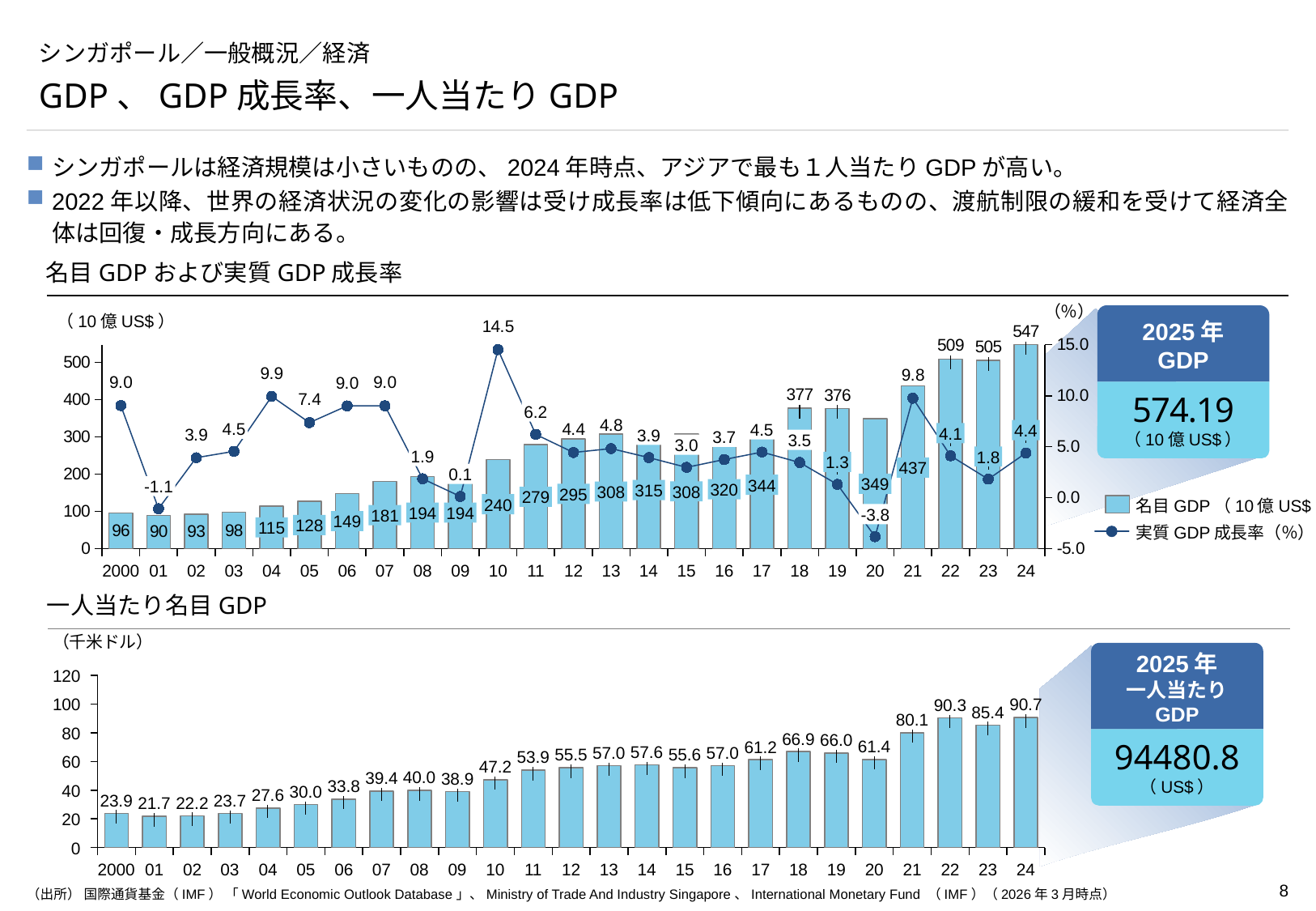
In the top chart (名目GDPおよび実質GDP成長率), what is the difference between the nominal GDP of 2022 and 2021? 72 In the bottom chart (一人当たり名目GDP), which year has the lowest value? 2001 What kind of chart is the bottom chart (一人当たり名目GDP)? Bar chart In the top chart (名目GDPおよび実質GDP成長率), which year has the lowest real GDP growth rate? 2020 In the top chart (名目GDPおよび実質GDP成長率), what is the nominal GDP value for 2024? 547 In the top chart (名目GDPおよび実質GDP成長率), what is the real GDP growth rate for 2001? -1.1 In the top chart (名目GDPおよび実質GDP成長率), which year has the highest nominal GDP? 2024 In the bottom chart (一人当たり名目GDP), what is the value for 2022? 90.3 In the bottom chart (一人当たり名目GDP), which is larger, the value for 2023 or the value for 2024? 2024 In the bottom chart (一人当たり名目GDP), how many years are plotted? 25 In the top chart (名目GDPおよび実質GDP成長率), what is the real GDP growth rate for 2010? 14.5 In the top chart (名目GDPおよび実質GDP成長率), how many series does the legend list? 2